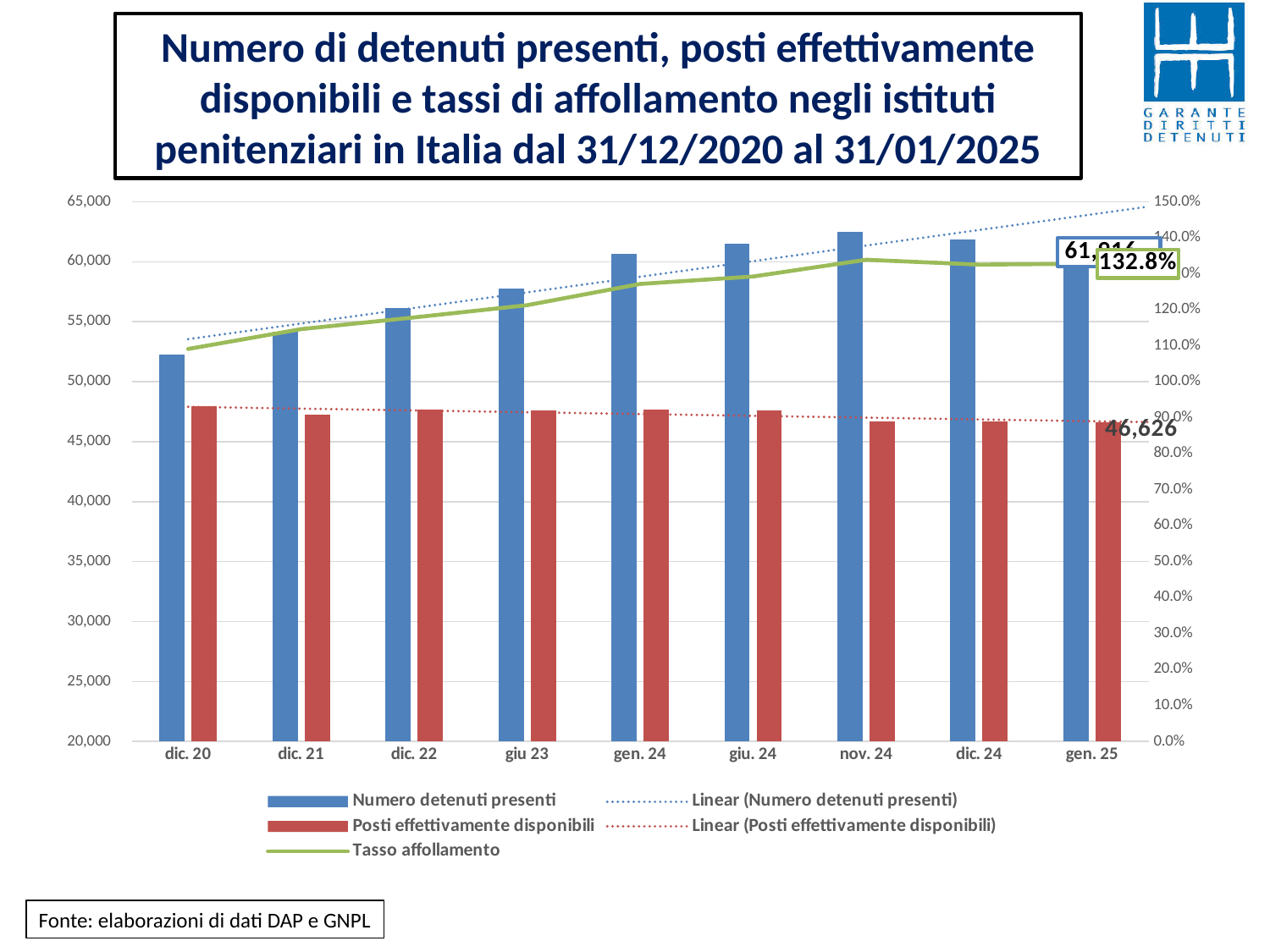
How many entries does the legend list? 5 How many time periods are shown on the x axis? 9 Does the Tasso affollamento line generally rise or fall from dic. 20 to gen. 25? rise Which is larger: Numero detenuti presenti in dic. 20 or in dic. 22? dic. 22 Which is larger in gen. 25: Numero detenuti presenti or Posti effettivamente disponibili? Numero detenuti presenti What is the value of Posti effettivamente disponibili for gen. 25? 46,626 Is the Posti effettivamente disponibili value for dic. 21 greater or less than 50,000? less Is the Numero detenuti presenti value for dic. 20 greater or less than 55,000? less In which period is the Numero detenuti presenti bar the lowest? dic. 20 In which period is the Numero detenuti presenti bar the highest? nov. 24 Is the Numero detenuti presenti value for giu. 24 greater or less than 60,000? greater What is the Tasso affollamento value shown for gen. 25? 132.8%